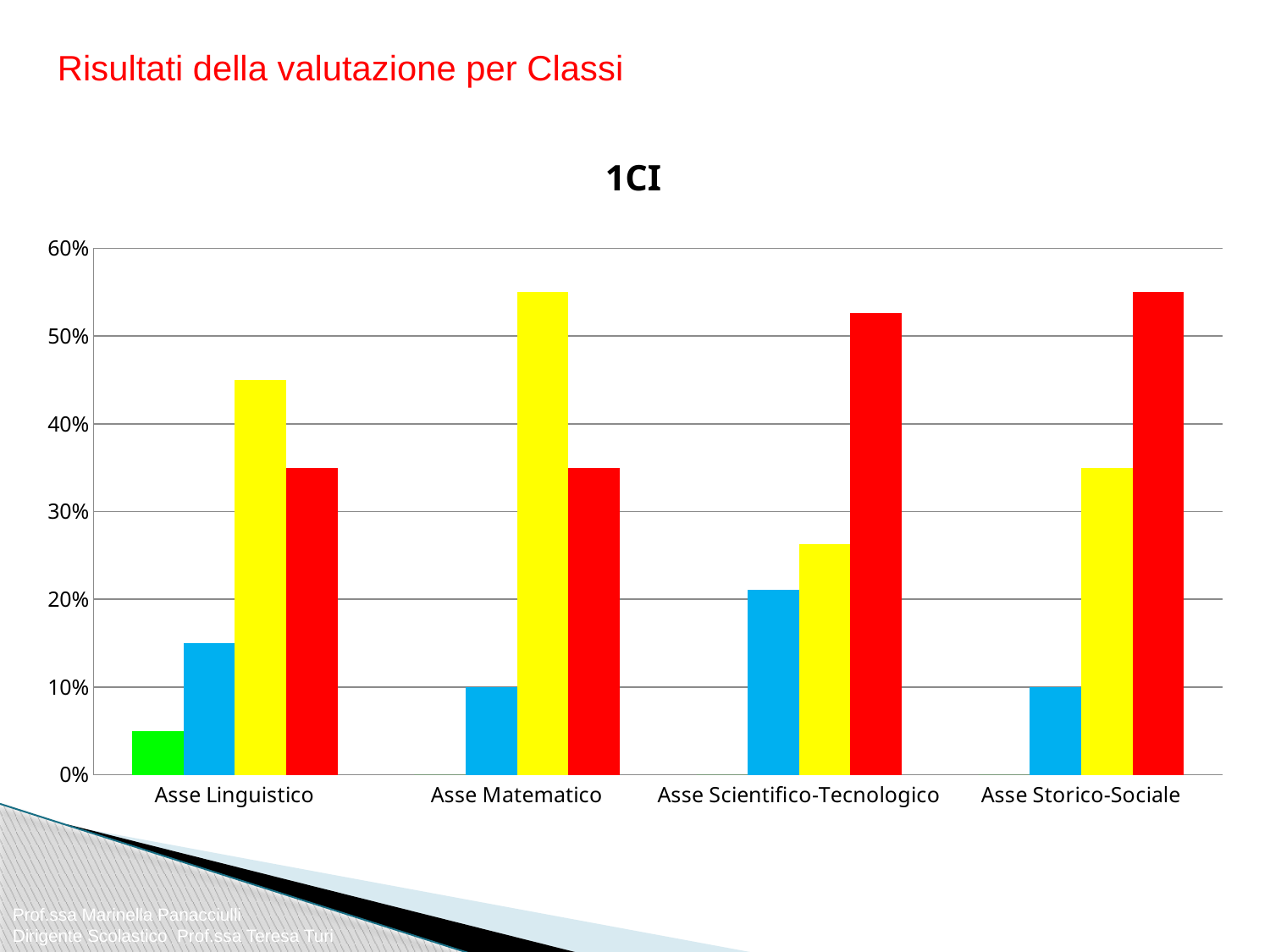
Is the value of the yellow bar for Asse Matematico greater or less than 50%? greater Which category has the shortest yellow bar? Asse Scientifico-Tecnologico What is the value of the blue bar for Asse Matematico? 10% Is the value of the green bar for Asse Linguistico greater or less than 10%? less What type of chart is shown on the slide? bar chart How many categories are shown on the x axis of the chart? 4 Which category is the only one with a green bar? Asse Linguistico For Asse Scientifico-Tecnologico, which is taller: the red bar or the yellow bar? the red bar Which category has the tallest yellow bar? Asse Matematico What is the value of the blue bar for Asse Storico-Sociale? 10% Is the value of the red bar for Asse Linguistico greater or less than 40%? less What is the title of the chart? 1CI